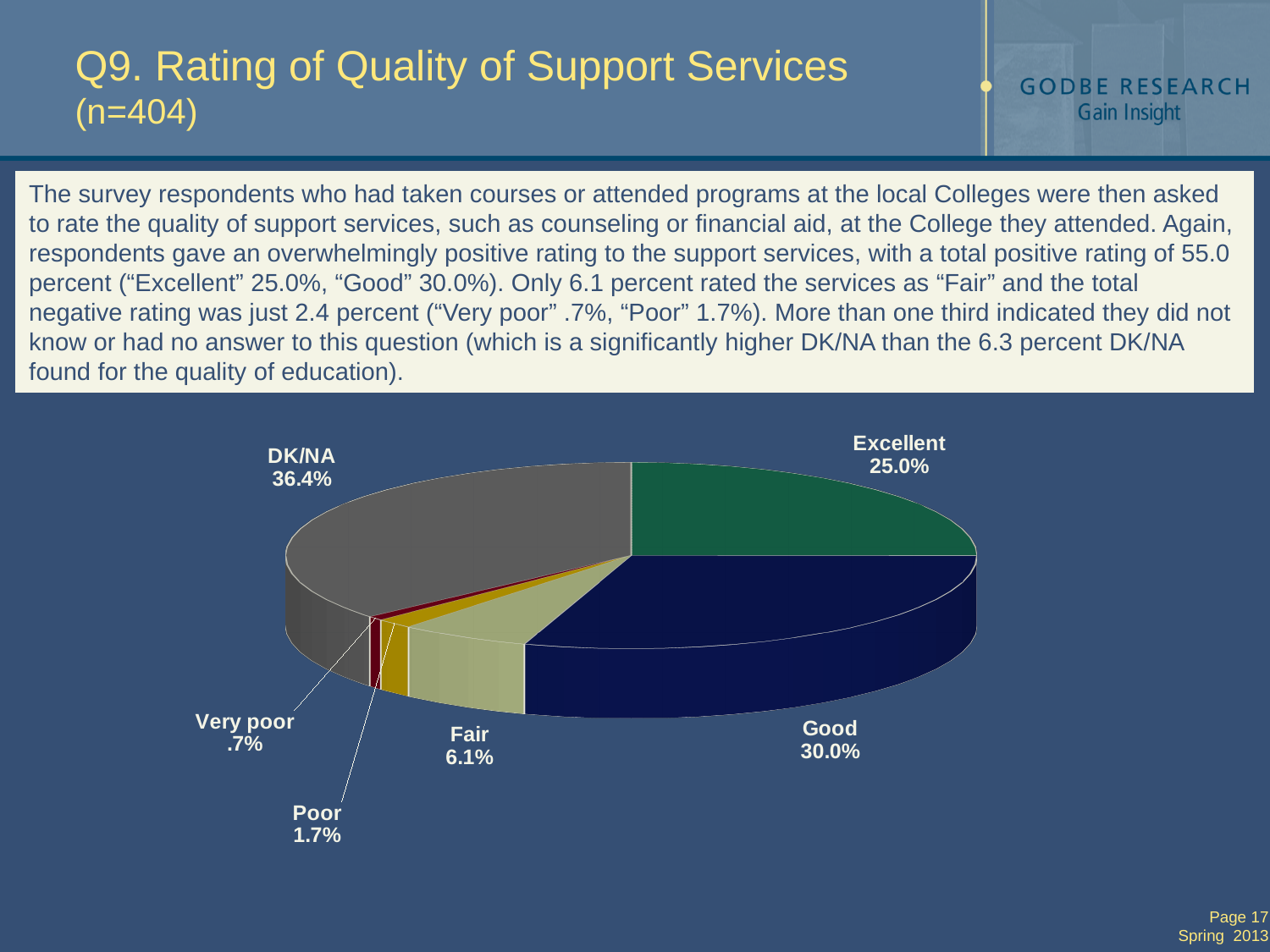
What percentage of respondents rated the support services as Excellent? 25.0% What is the value shown for the Fair slice? 6.1% What kind of chart is shown on the slide? Pie chart What is the difference between the Good and Excellent percentages? 5.0% Which is larger, the Fair slice or the Poor slice? Fair How many categories are shown in the pie chart? 6 Which category has the largest share of the pie? DK/NA What is the combined percentage of the Excellent and Good slices? 55.0% Which category has the smallest share of the pie? Very poor What is the value shown for the Very poor slice? .7% What percentage of respondents rated the support services as Good? 30.0% What is the value shown for the DK/NA slice? 36.4%